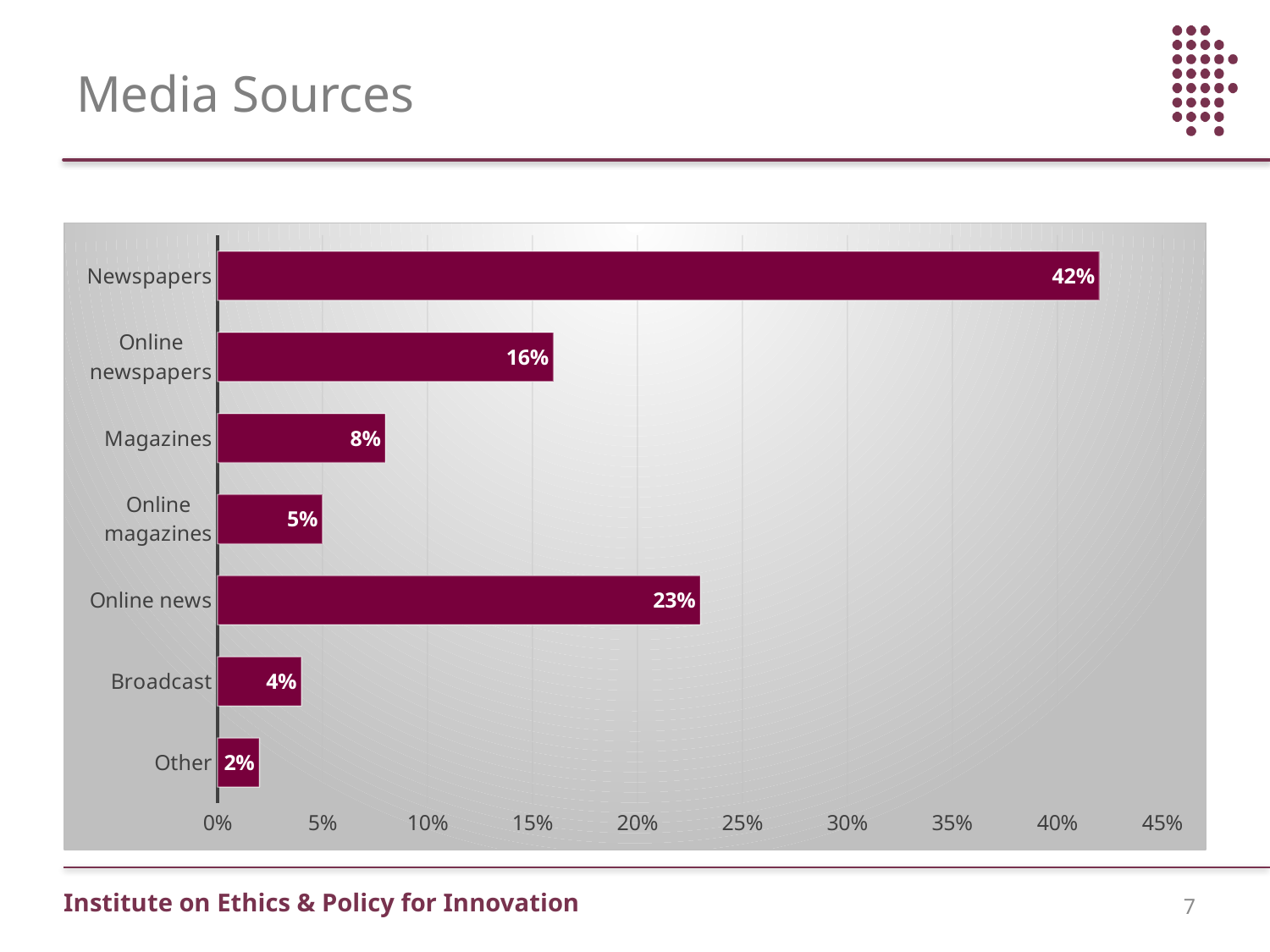
What is the value for Online magazines? 5% Which is larger, the value for Broadcast or the value for Magazines? Magazines What is the difference between the values for Newspapers and Online news? 19% What kind of chart is shown on the slide? bar chart How many categories are shown in the chart? 7 Which category has the lowest value? Other Which category has the highest value? Newspapers What is the value for Newspapers? 42% Is the value for Online newspapers greater or less than 20%? less What is the title of the slide? Media Sources What is the difference between the values for Online newspapers and Magazines? 8% What is the value for Online news? 23%